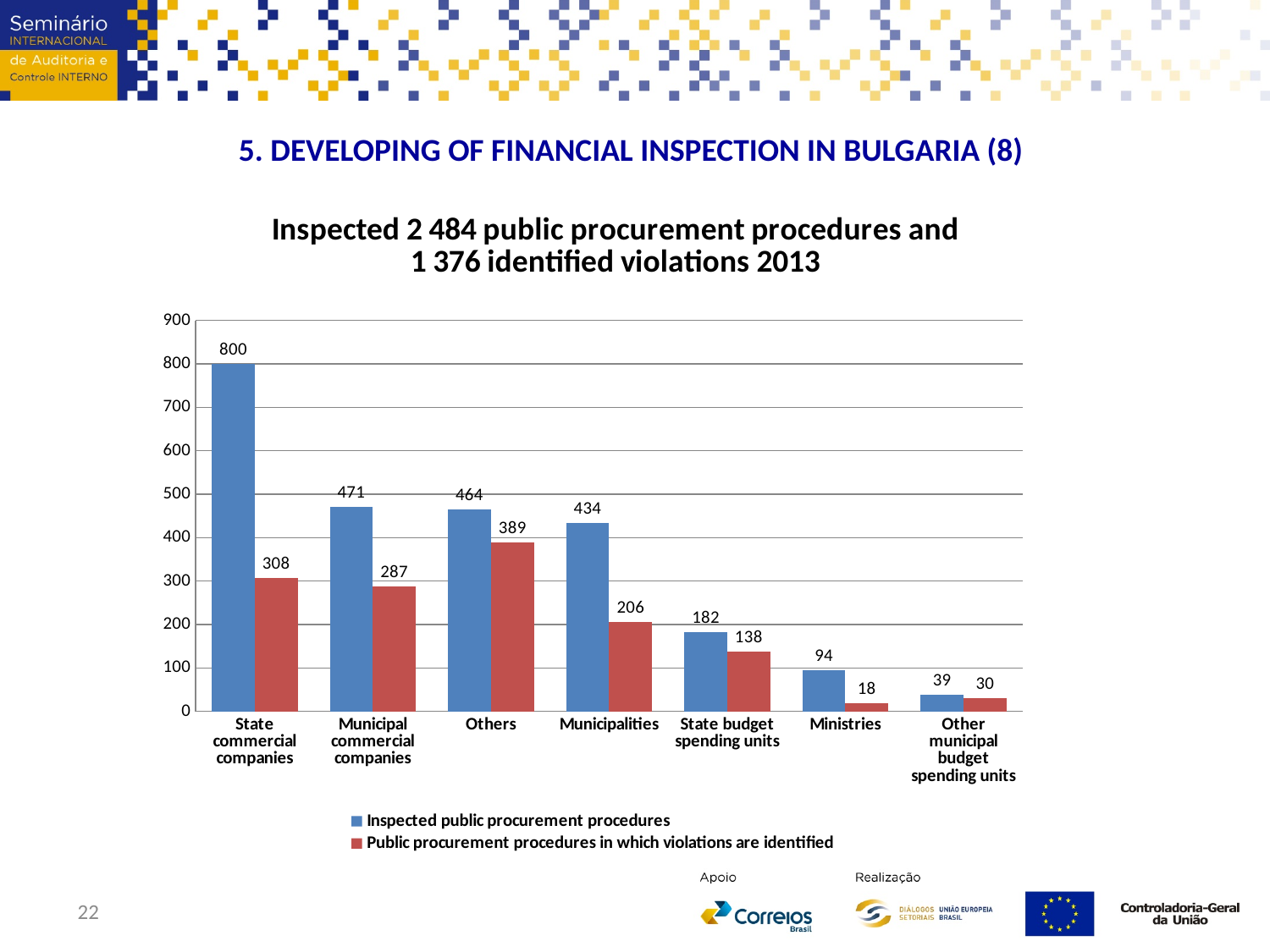
How many categories are shown on the x axis? 7 Which category has the lowest number of public procurement procedures in which violations are identified? Ministries Do the values for inspected public procurement procedures rise or fall from left to right along the x axis? fall What is the difference between inspected procedures and procedures with identified violations for Municipalities? 228 Is the value for inspected procedures for State budget spending units greater or less than 200? less Which is larger: the inspected procedures for Municipal commercial companies or for Others? Municipal commercial companies What kind of chart is shown on the slide? bar chart How many inspected public procurement procedures are shown for Ministries? 94 What is the value for Public procurement procedures in which violations are identified for Others? 389 Which category has the highest number of inspected public procurement procedures? State commercial companies How many series does the legend list? 2 How many inspected public procurement procedures are shown for State commercial companies? 800